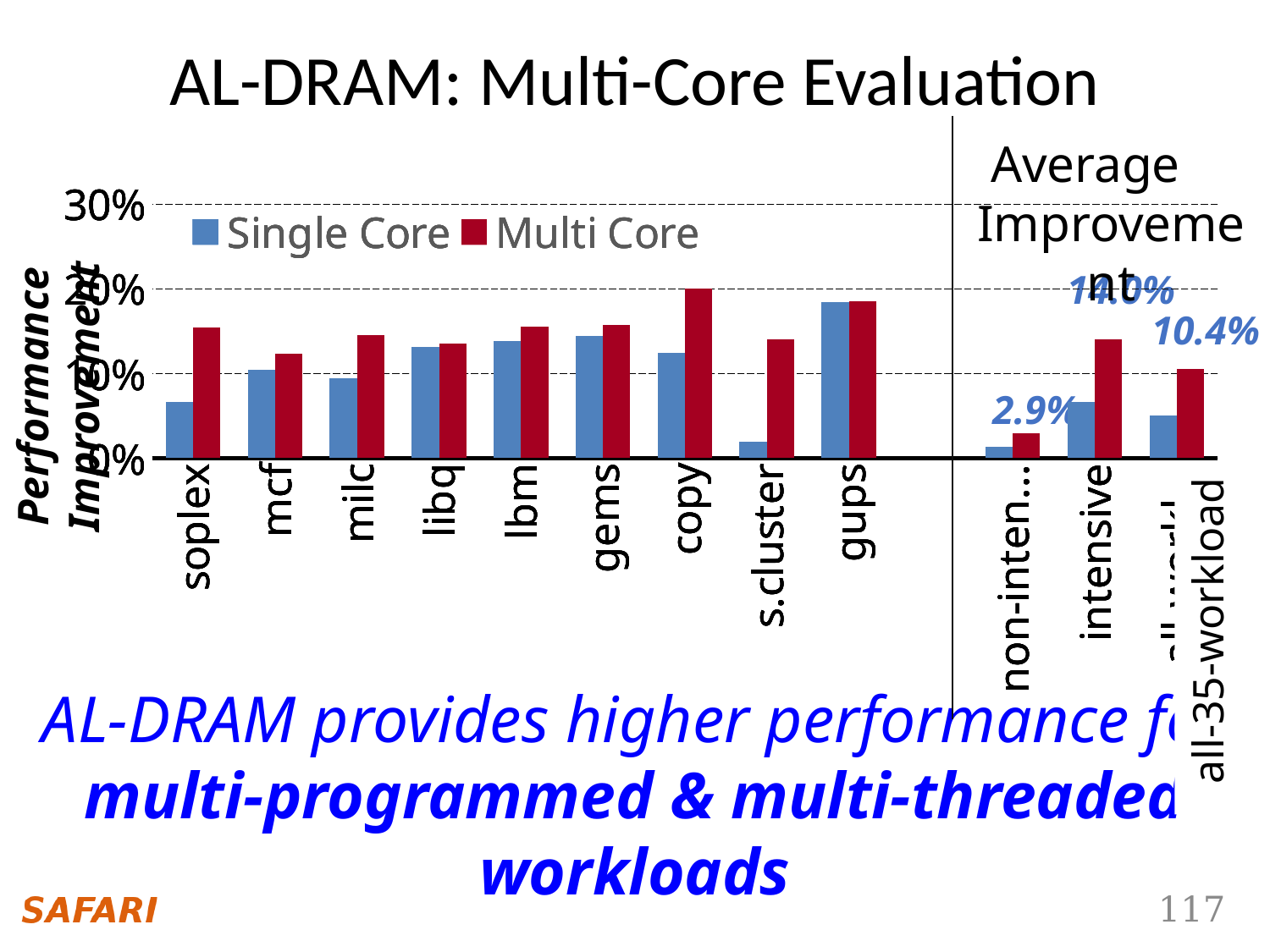
Which category has the highest Single Core performance improvement? gups What kind of chart is shown on the slide? bar chart Is the Single Core performance improvement for soplex greater or less than 10%? less For copy, which is larger: the Single Core or the Multi Core performance improvement? Multi Core For soplex, which is larger: the Single Core or the Multi Core performance improvement? Multi Core What colour are the Multi Core bars? red What is the labelled average performance improvement for the all-35-workload category? 10.4% What is the labelled average performance improvement for the non-intensive category? 2.9% What are the two series named in the legend? Single Core and Multi Core Is the Single Core performance improvement for gups greater or less than 10%? greater How many series does the legend list? 2 Which category has the lowest Multi Core performance improvement? non-intensive